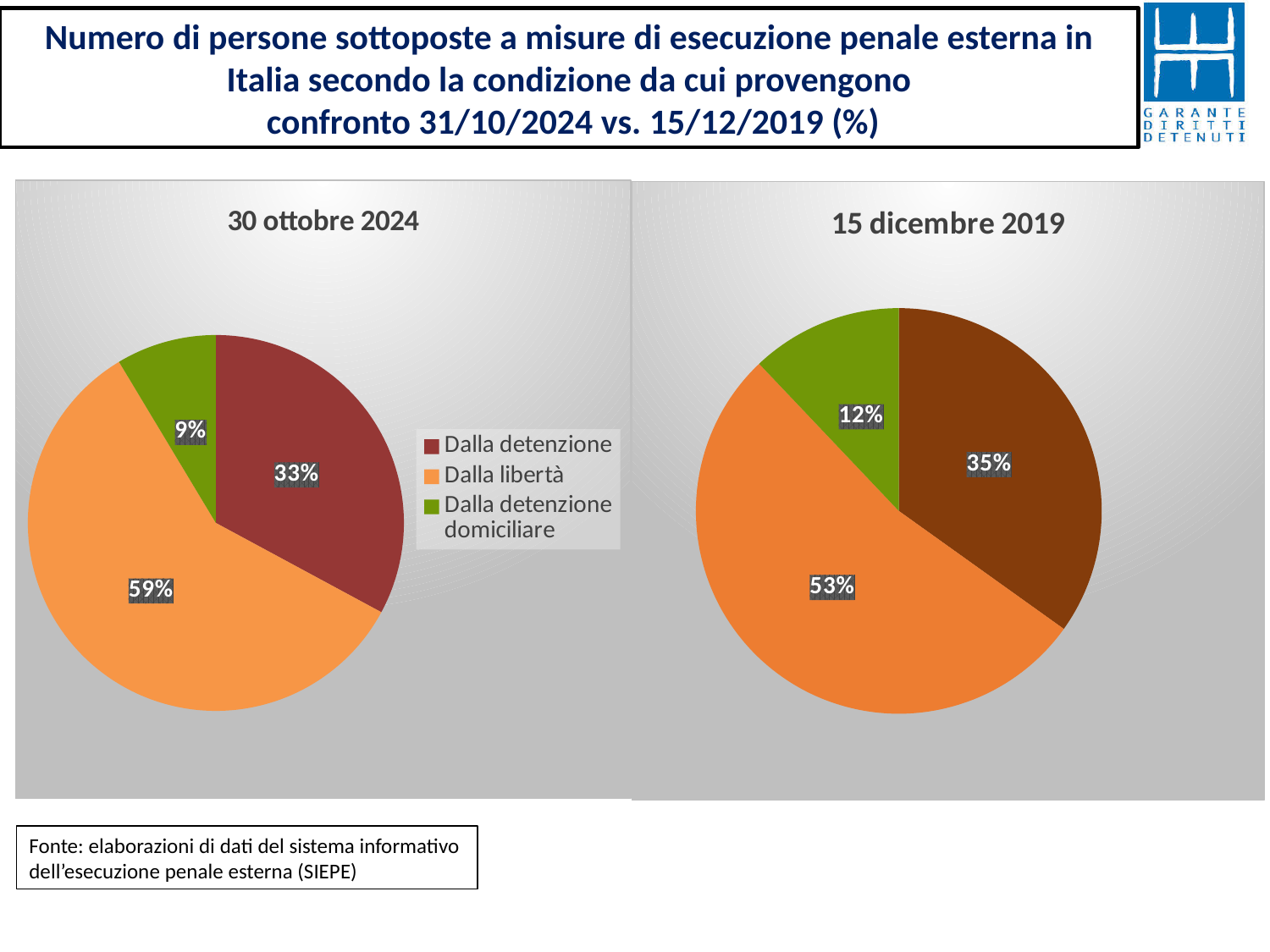
In the '30 ottobre 2024' chart, what share is labelled for 'Dalla detenzione'? 33% How many entries does the legend of the '30 ottobre 2024' chart list? 3 In the '30 ottobre 2024' chart, what share is labelled for 'Dalla detenzione domiciliare'? 9% In the '30 ottobre 2024' chart, what is the difference in percentage points between 'Dalla libertà' and 'Dalla detenzione'? 26 What kind of charts are shown on the slide? Pie charts In the '30 ottobre 2024' chart, which category has the largest slice? Dalla libertà In the '30 ottobre 2024' chart, what share is labelled for 'Dalla libertà'? 59% In the '15 dicembre 2019' chart, what percentage is shown on the brown slice? 35% Which is larger: the 'Dalla detenzione' share in the '30 ottobre 2024' chart or the brown 'Dalla detenzione' share in the '15 dicembre 2019' chart? 15 dicembre 2019 In the '15 dicembre 2019' chart, what is the largest percentage shown? 53% In the '30 ottobre 2024' chart, which category has the smallest slice? Dalla detenzione domiciliare In the '15 dicembre 2019' chart, what is the smallest percentage shown? 12%